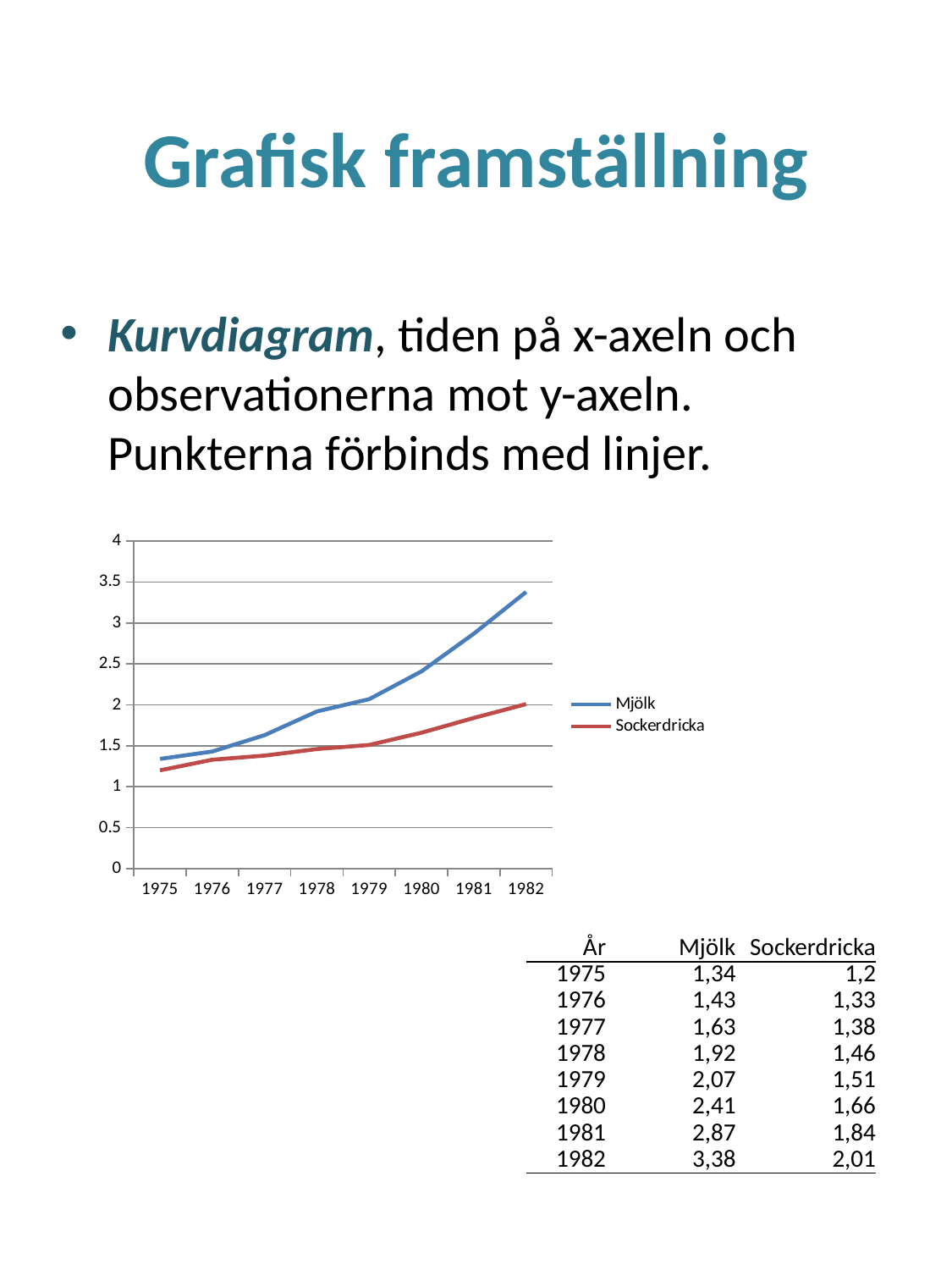
What is the difference between the Mjölk and Sockerdricka values in 1982? 1,37 Do the Mjölk values rise or fall from 1975 to 1982? rise What is the value for Sockerdricka in 1975? 1,2 What is the value for Mjölk in 1982? 3,38 In which year is the Sockerdricka value lowest? 1975 Is the value for Mjölk in 1981 greater or less than 2.5? greater What is the value for Mjölk in 1979? 2,07 How many series does the chart's legend list? 2 Which series has the larger value in 1980, Mjölk or Sockerdricka? Mjölk What kind of chart is shown on the slide? line chart How many years are plotted along the x axis of the chart? 8 In which year is the Mjölk value highest? 1982